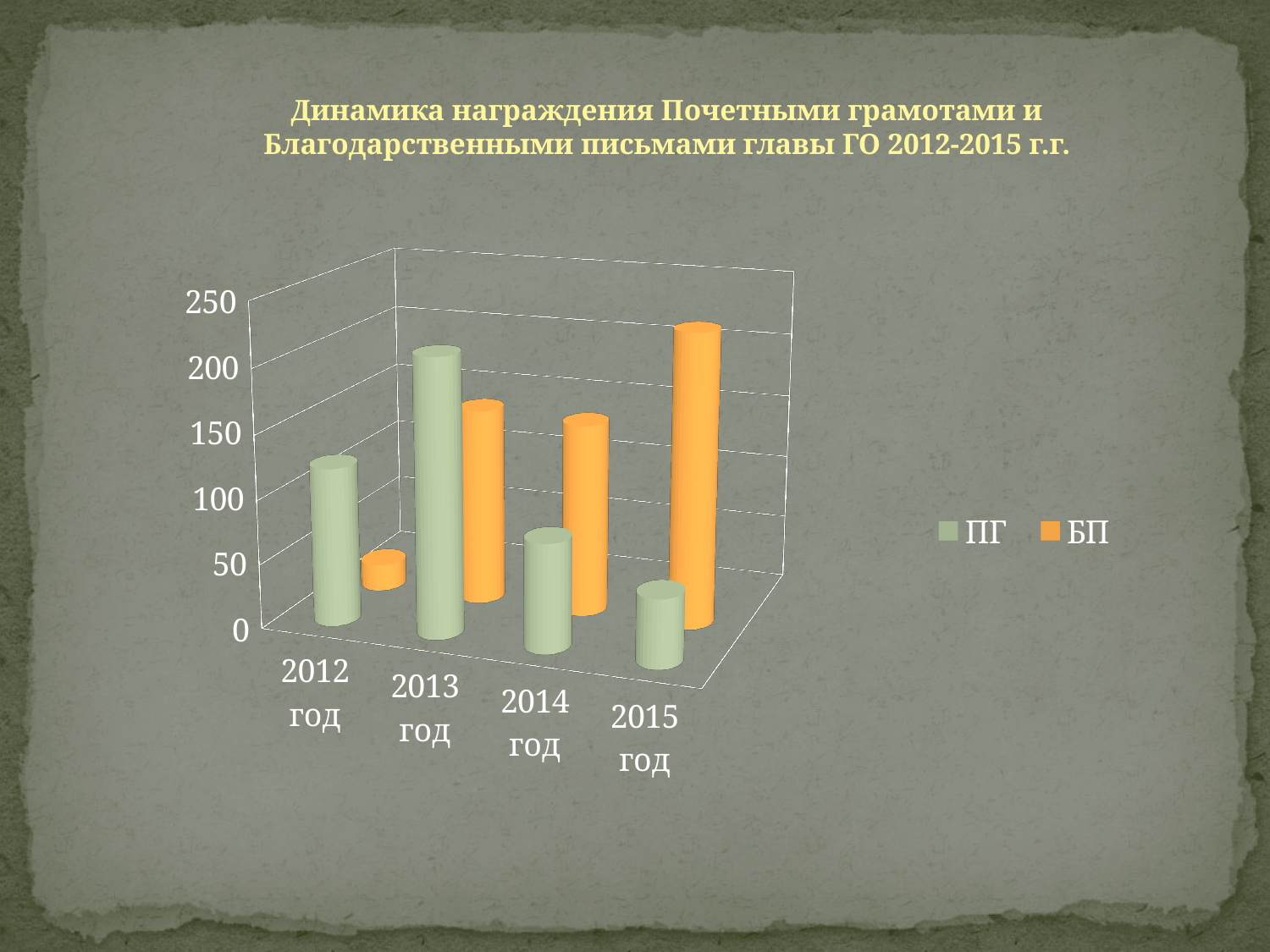
How many series does the legend list? 2 Which year has the highest value for ПГ? 2013 год Which series is shown in orange in the legend? БП In 2015 год, which series has the larger value, ПГ or БП? БП Is the value for БП in 2012 год greater or less than 100? less Is the value for ПГ in 2013 год greater or less than 150? greater What kind of chart is shown on the slide? bar chart Which year has the highest value for БП? 2015 год Which year has the lowest value for БП? 2012 год Which year has the lowest value for ПГ? 2015 год How many years (categories) are shown on the x axis? 4 In 2012 год, which series has the larger value, ПГ or БП? ПГ